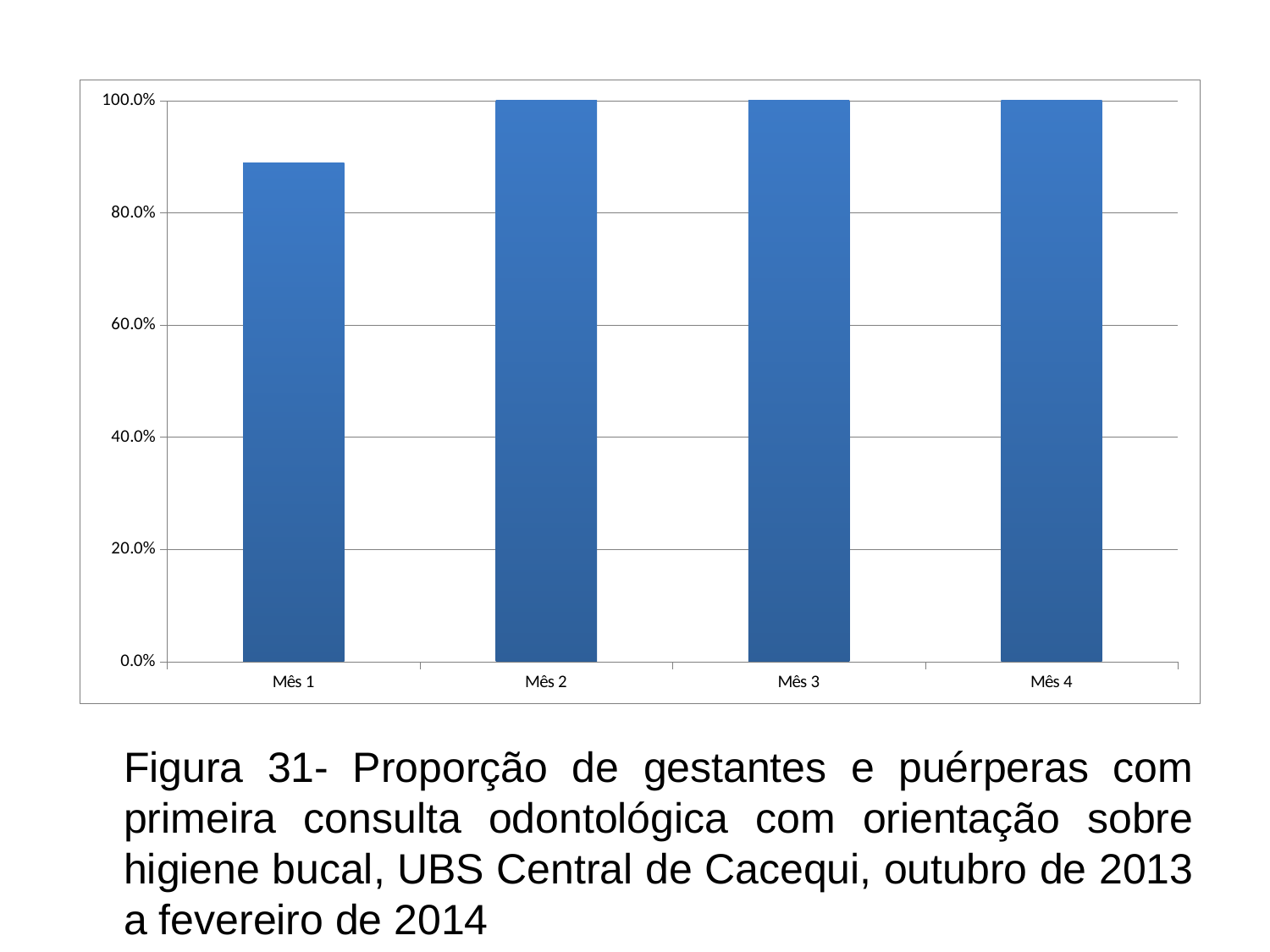
What kind of chart is shown on the slide? bar chart Is the value for Mês 1 greater or less than 100.0%? less Which category has the lowest value? Mês 1 Which is larger, the value for Mês 1 or the value for Mês 2? Mês 2 How many categories are shown on the x axis of the chart? 4 What is the value for Mês 3? 100.0% What figure number is given in the caption below the chart? Figura 31 What is the value for Mês 4? 100.0% What is the value for Mês 2? 100.0% Do the values rise or fall from Mês 1 to Mês 2? rise What is the highest value shown on the y axis? 100.0% Is the value for Mês 1 greater or less than 80.0%? greater